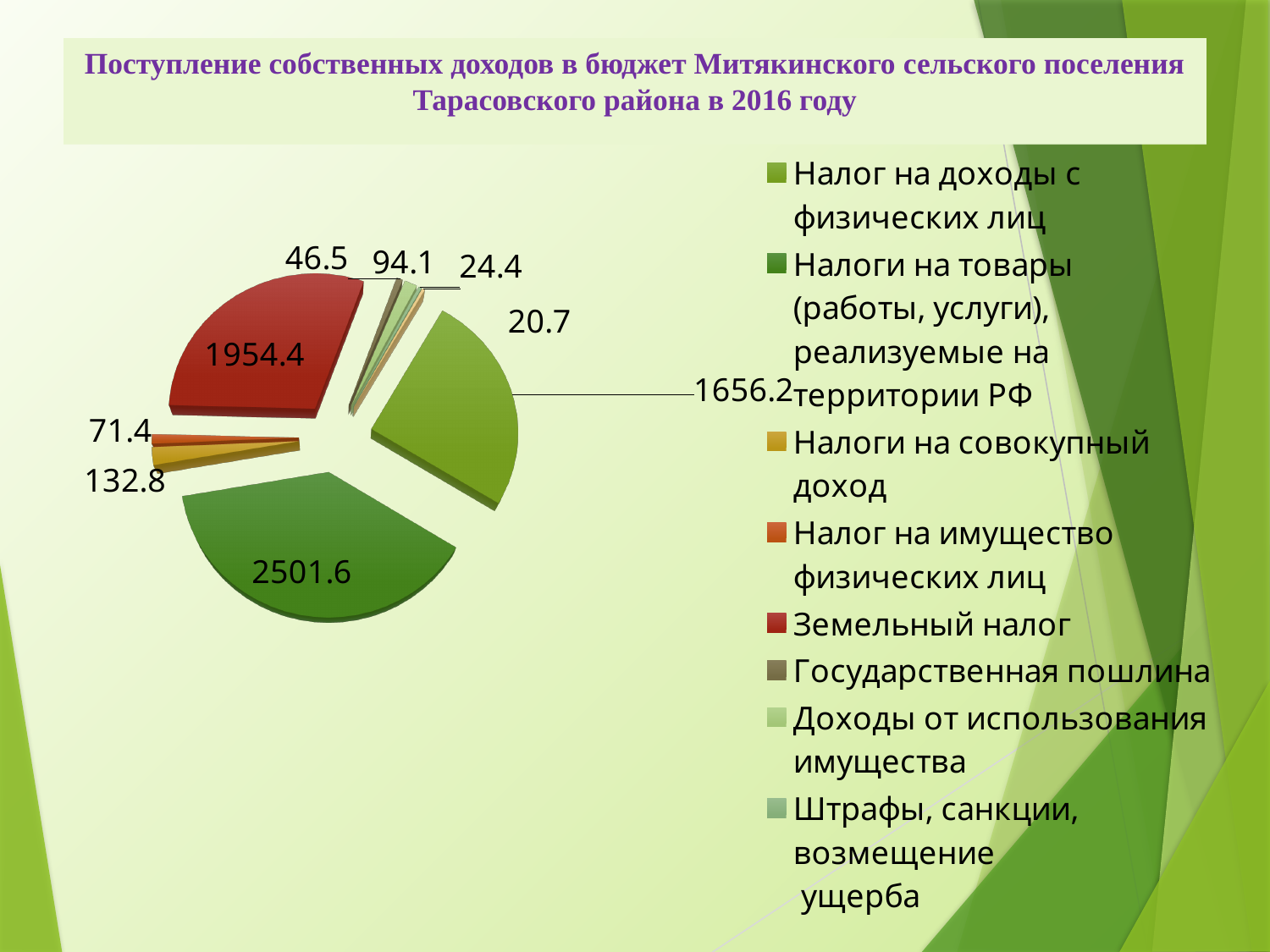
Which category has the largest slice of the pie? Налоги на товары (работы, услуги), реализуемые на территории РФ What is the value for Налог на доходы с физических лиц? 1656.2 How many entries does the legend list? 8 What type of chart is shown on the slide? pie chart What is the value for Земельный налог? 1954.4 What year does the chart title refer to? 2016 Which is larger: Земельный налог or Налог на доходы с физических лиц? Земельный налог What is the difference between the values for Налоги на товары (работы, услуги) and Земельный налог? 547.2 What is the value for Налоги на товары (работы, услуги), реализуемые на территории РФ? 2501.6 What is the value for Налог на имущество физических лиц? 71.4 What is the smallest value labelled on the pie chart? 20.7 What is the value for Налоги на совокупный доход? 132.8